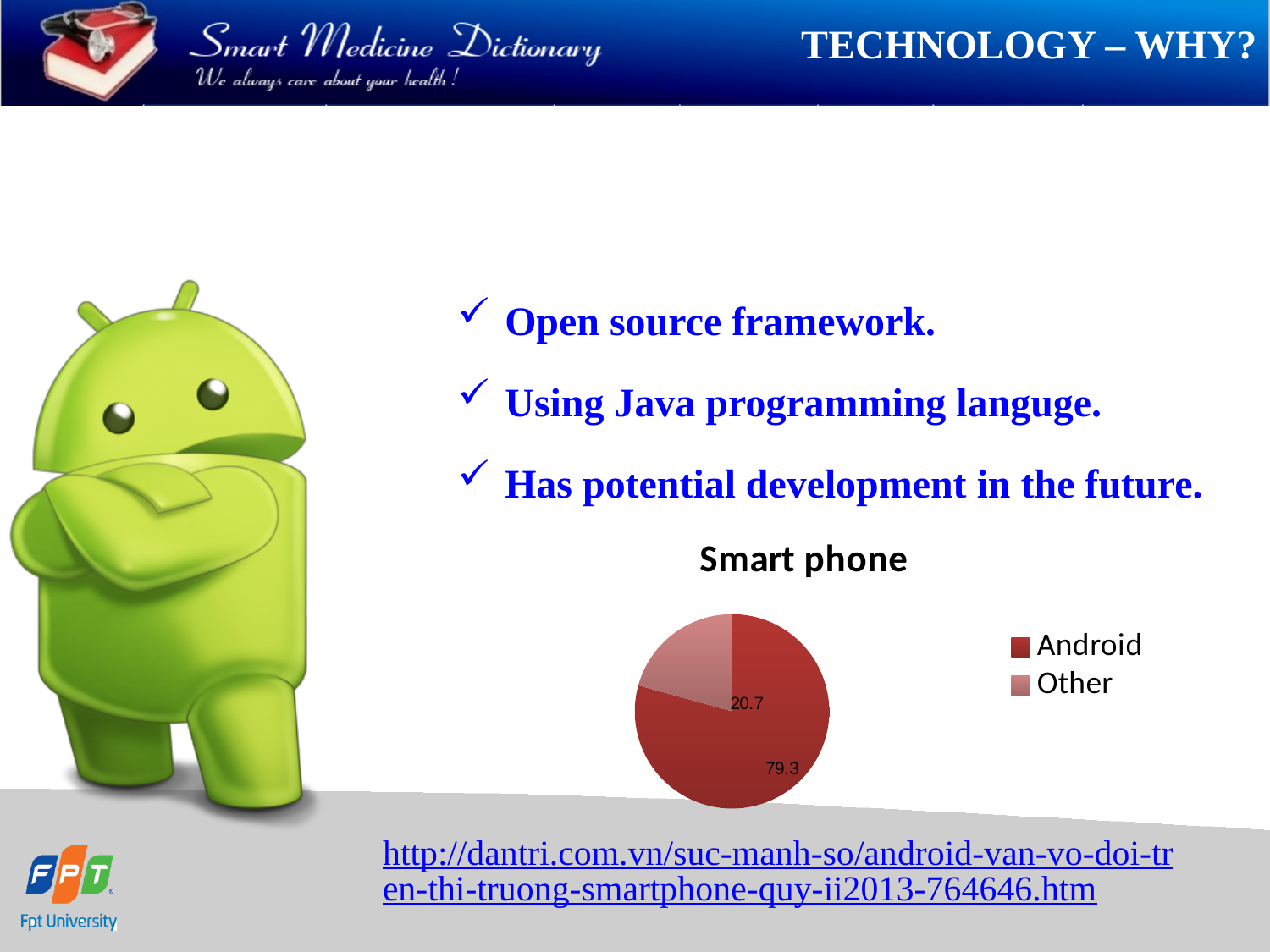
What is the title of the chart? Smart phone What kind of chart is shown on the slide? pie chart Which slice of the pie chart is the largest? Android How many entries does the legend list? 2 How many slices does the pie chart have? 2 What is the value for Other in the pie chart? 20.7 What is the total of the two values shown in the pie chart? 100 What is the difference between the Android and Other values? 58.6 What are the two legend entries of the pie chart? Android and Other Which slice of the pie chart is the smallest? Other Which is larger, the Android slice or the Other slice? Android What is the value for Android in the pie chart? 79.3